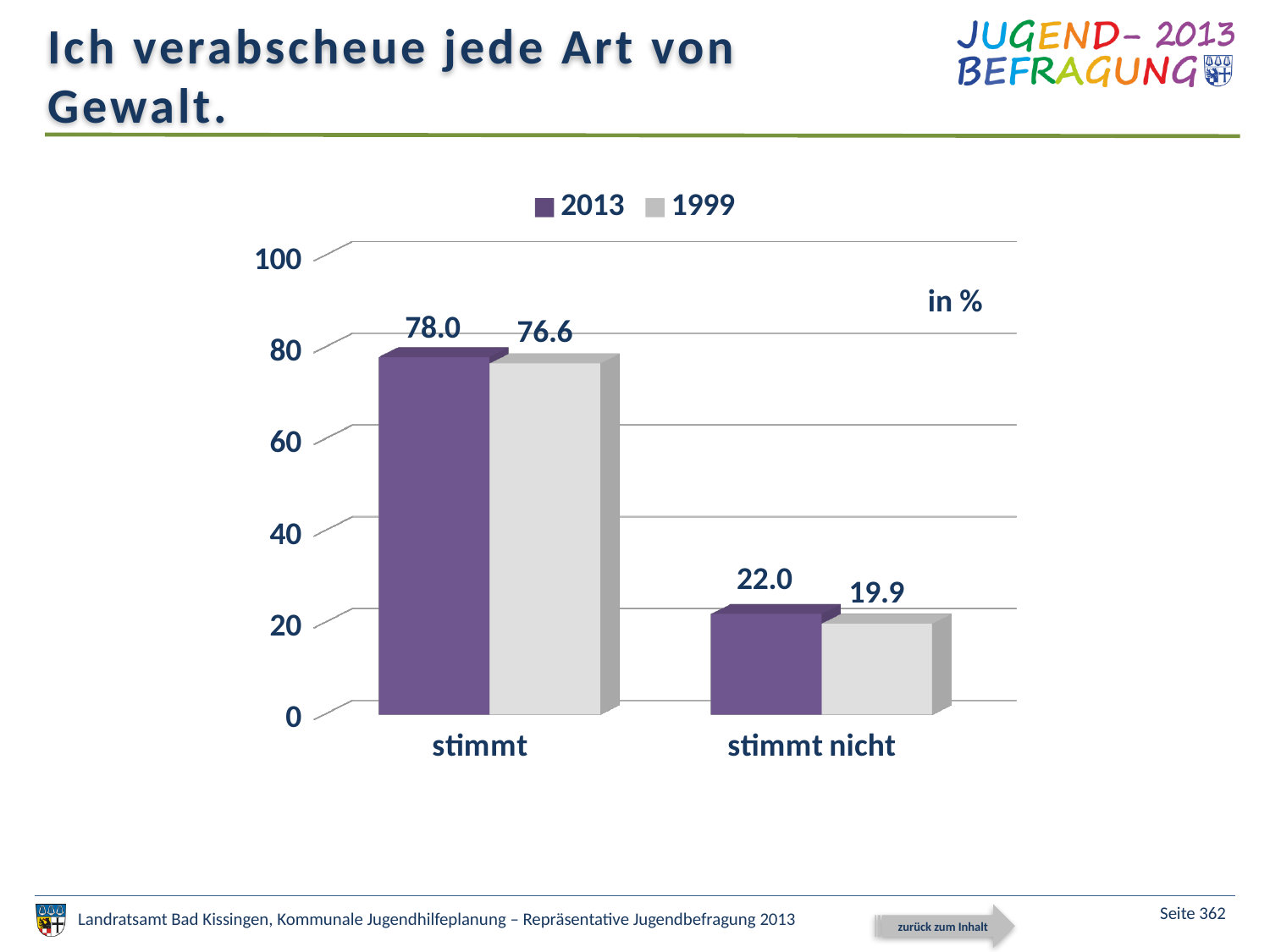
What is the value for "stimmt nicht" in the 1999 series? 19.9 What is the value for "stimmt nicht" in the 2013 series? 22.0 What kind of chart is shown on the slide? bar chart Is the 2013 value for "stimmt nicht" greater or less than 40? less Which category has the lowest value in the 1999 series? stimmt nicht What is the value for "stimmt" in the 1999 series? 76.6 What is the value for "stimmt" in the 2013 series? 78.0 How many series does the legend list? 2 What is the difference between the 2013 and 1999 values for "stimmt"? 1.4 What is the difference between the 2013 and 1999 values for "stimmt nicht"? 2.1 Which category has the highest value in the 2013 series? stimmt How many categories are shown on the x axis? 2